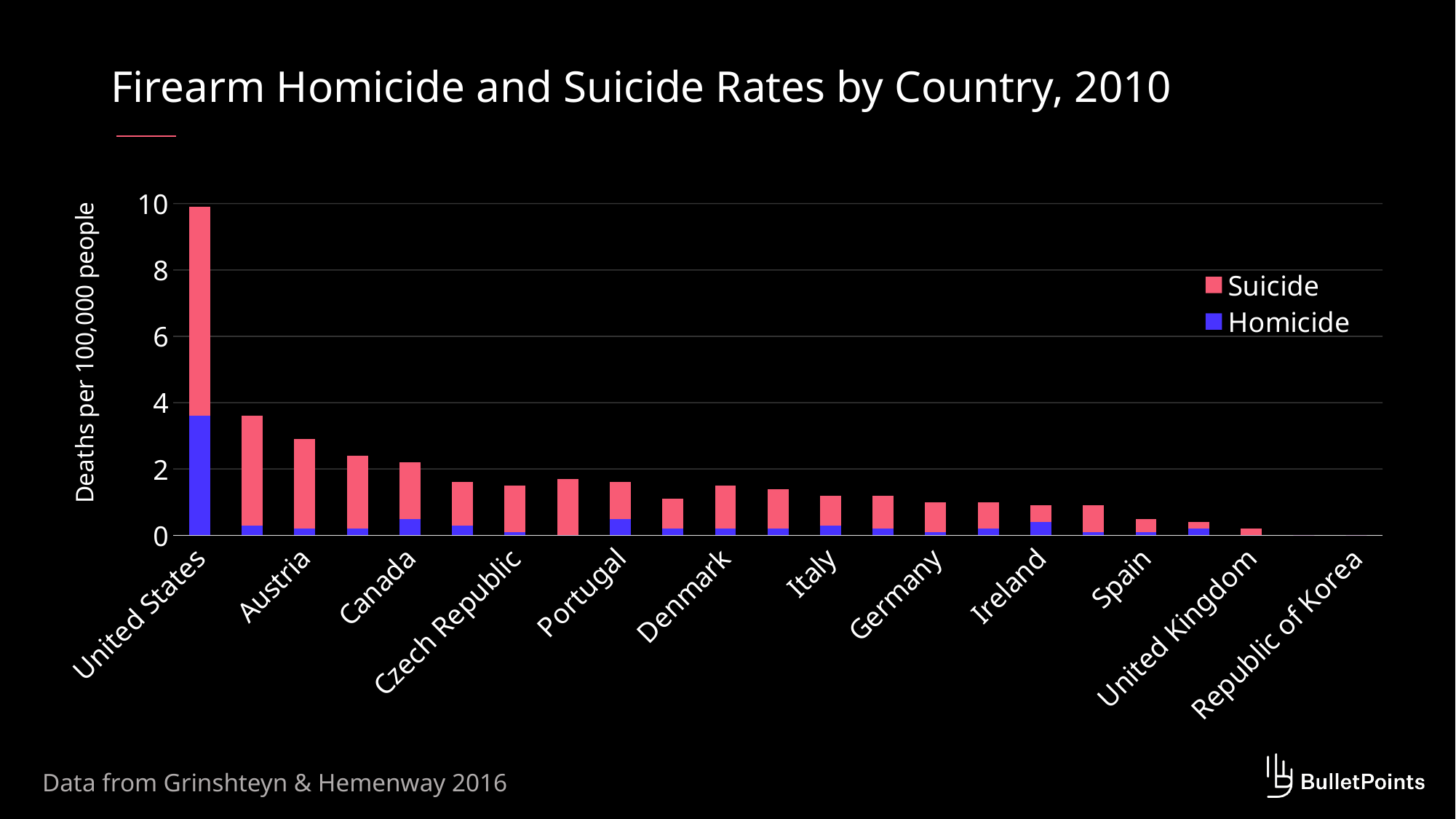
How many series does the legend list? 2 Which colour represents Homicide in the legend? Blue Is the total value for Austria greater or less than 4? less Which labelled country has the lowest total firearm death rate? Republic of Korea Which has a higher total firearm death rate, Austria or Canada? Austria Which has a higher total firearm death rate, Italy or Spain? Italy Is the total value for the United States greater or less than 8? greater Which country has the highest total firearm death rate? United States Is the homicide value for the United States greater or less than 2? greater Do the total values generally rise or fall from left to right along the x axis? fall What kind of chart is shown on the slide? Stacked bar chart What is the label on the vertical axis? Deaths per 100,000 people